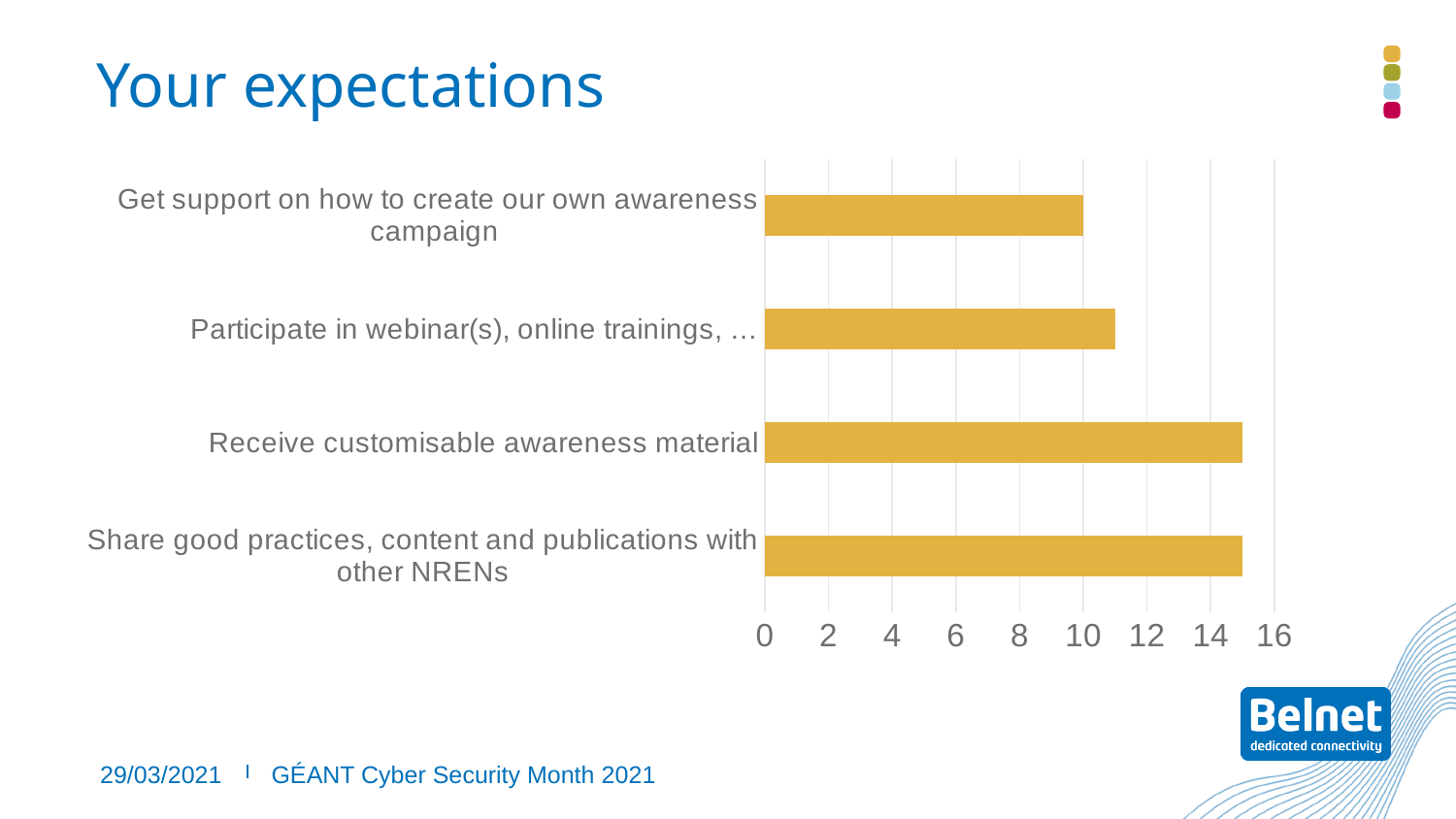
What is the highest value shown on the chart's horizontal axis? 16 How many categories are plotted in the chart? 4 Is the value for "Receive customisable awareness material" greater or less than 14? greater Which is larger: the value for "Share good practices, content and publications with other NRENs" or the value for "Participate in webinar(s), online trainings, …"? Share good practices, content and publications with other NRENs Which category has the lowest value? Get support on how to create our own awareness campaign What kind of chart is shown on the slide? bar chart What is the value for "Get support on how to create our own awareness campaign"? 10 Is the value for "Participate in webinar(s), online trainings, …" greater or less than 10? greater Which is larger: the value for "Receive customisable awareness material" or the value for "Get support on how to create our own awareness campaign"? Receive customisable awareness material Is the value for "Share good practices, content and publications with other NRENs" greater or less than 16? less What is the title of the chart on the slide? Your expectations